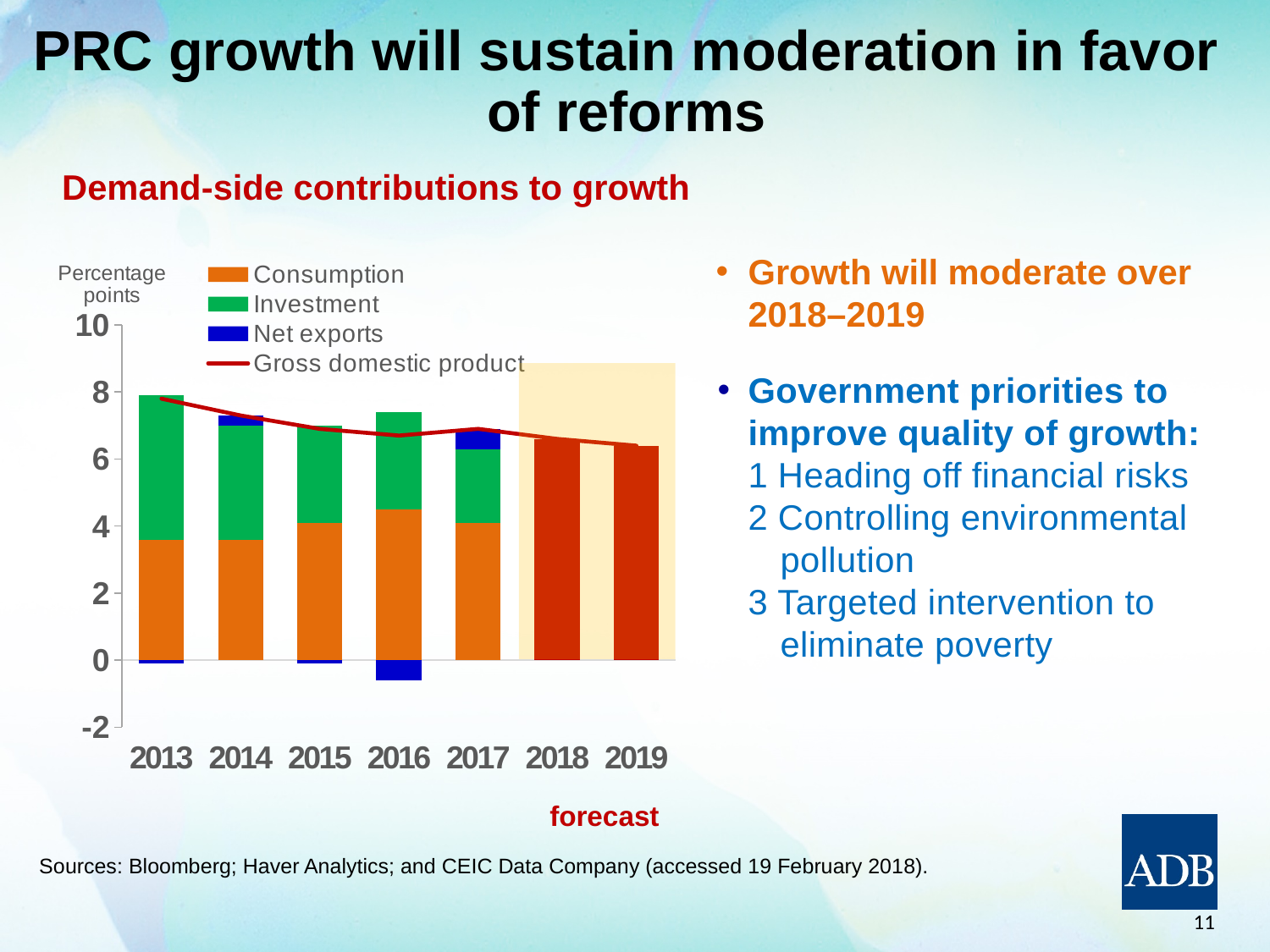
Is the Net exports contribution in 2016 greater or less than 0? less How many series does the chart legend list? 4 Is the Gross domestic product growth in 2013 greater or less than 8 percentage points? less Does the Gross domestic product line rise or fall from 2013 to 2019? Fall Is the forecast growth bar for 2019 greater or less than 6 percentage points? greater What is the title of the chart? Demand-side contributions to growth Which years in the chart are marked as forecast? 2018 and 2019 What kind of chart is shown on the slide? Stacked bar chart with a line Which year has the larger Investment contribution, 2013 or 2017? 2013 How many years are shown on the x axis of the chart? 7